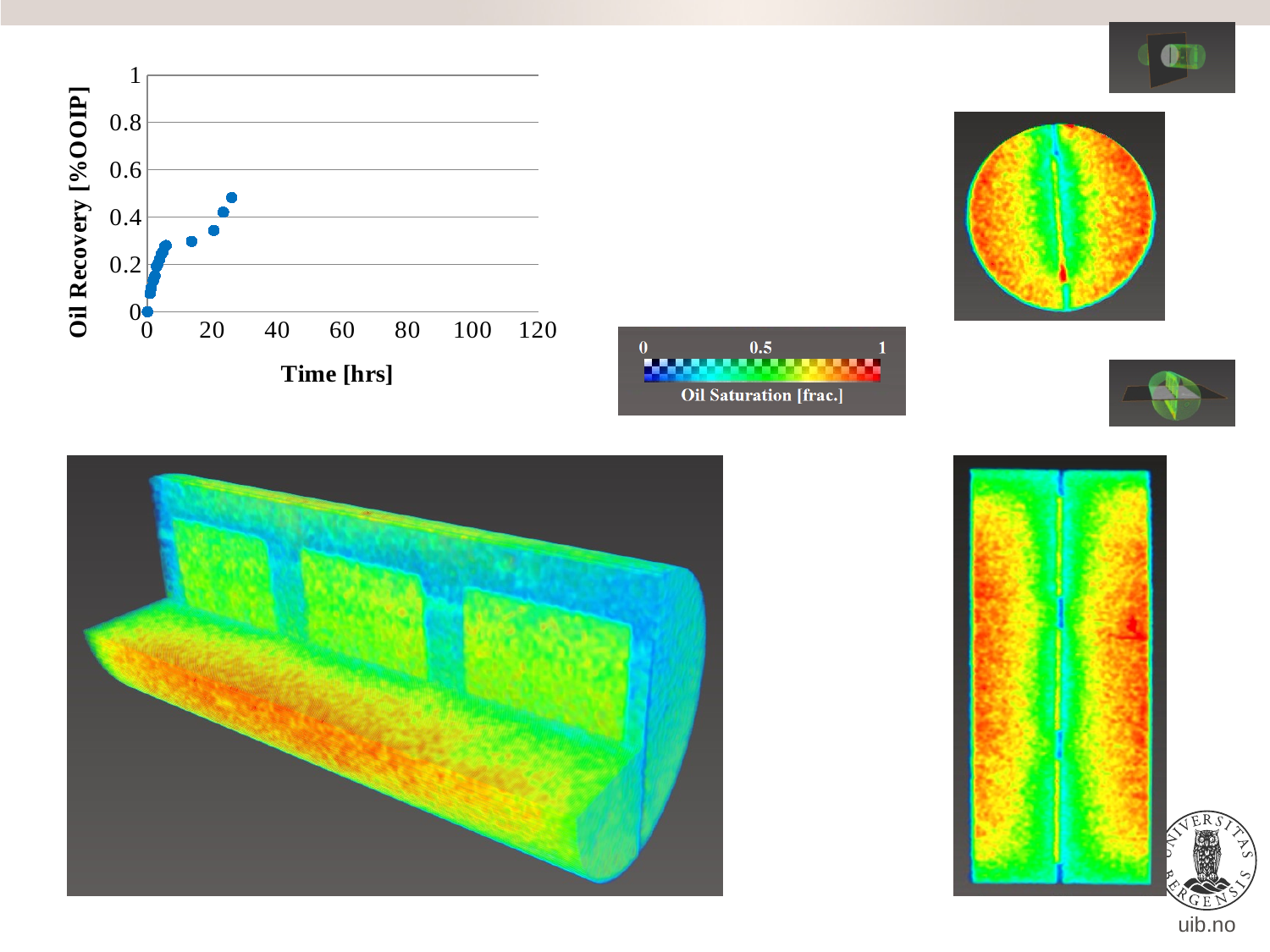
Is the oil recovery value at about 20 hours greater or less than 0.2? greater What is the label of the y axis of the scatter chart? Oil Recovery [%OOIP] What is the maximum value shown on the x axis of the scatter chart? 120 Is the highest oil recovery value plotted greater or less than 0.4? greater What is the maximum value shown on the y axis of the scatter chart? 1 Is the oil recovery value at about 20 hours greater or less than 0.4? less What kind of chart is shown at the top left of the slide? scatter chart Which is larger: the oil recovery at about 26 hours or the oil recovery at about 13 hours? about 26 hours What is the label of the x axis of the scatter chart? Time [hrs] Do the oil recovery values rise or fall as time increases along the x axis? rise